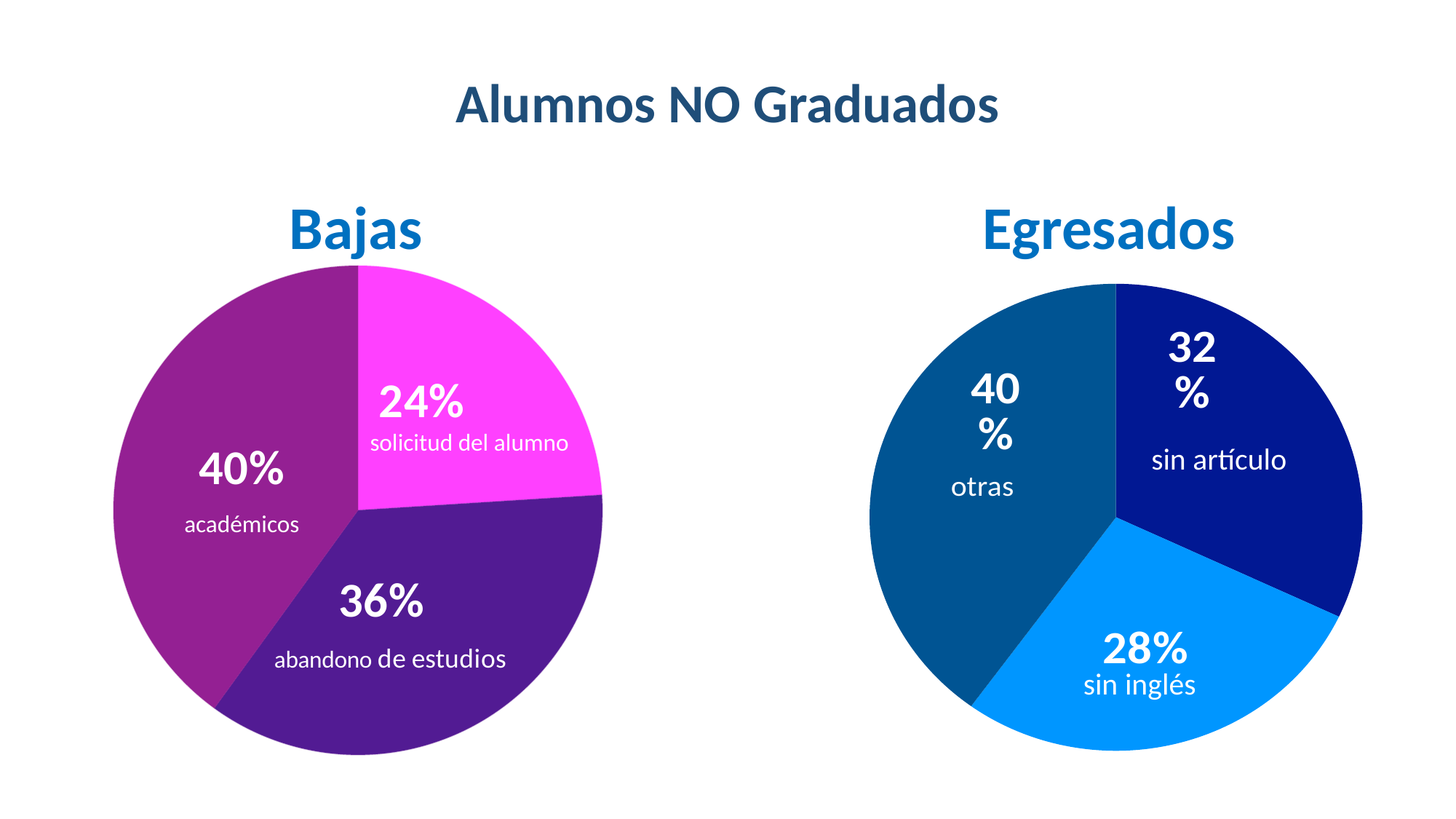
In the Bajas pie chart, what percentage is labelled for académicos? 40% How many slices does the Egresados pie chart have? 3 In the Egresados pie chart, which is larger, sin artículo or sin inglés? sin artículo In the Egresados pie chart, which category has the largest slice? otras In the Bajas pie chart, which category has the largest slice? académicos In the Egresados pie chart, which category has the smallest slice? sin inglés In the Bajas pie chart, what is the difference in percentage points between abandono de estudios and solicitud del alumno? 12 What type of chart is used for Bajas? Pie chart In the Bajas pie chart, what percentage is labelled for solicitud del alumno? 24% In the Egresados pie chart, what percentage is labelled for sin artículo? 32% In the Bajas pie chart, which category has the smallest slice? solicitud del alumno In the Egresados pie chart, what percentage is labelled for sin inglés? 28%